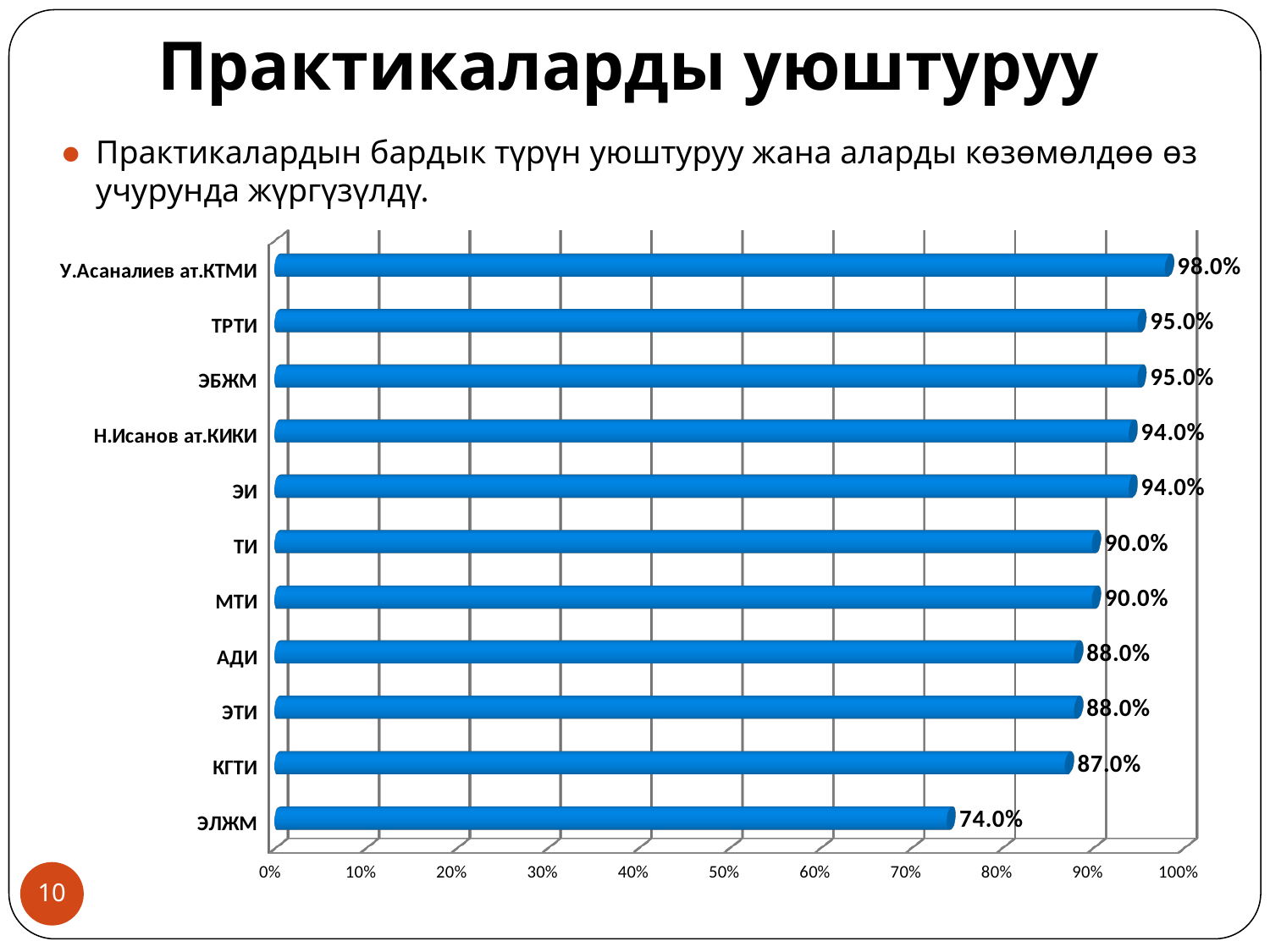
What is the value for ЭЛЖМ? 74.0% What kind of chart is shown on the slide? bar chart What is the value for У.Асаналиев ат.КТМИ? 98.0% What is the difference between the values for ТРТИ and КГТИ? 8.0% Which category has the lowest value? ЭЛЖМ What is the value for КГТИ? 87.0% How many categories are shown in the chart? 11 What is the difference between the values for У.Асаналиев ат.КТМИ and ЭЛЖМ? 24.0% What is the value for Н.Исанов ат.КИКИ? 94.0% Is the value for ЭЛЖМ greater or less than 80%? less Which is larger, the value for ТИ or the value for АДИ? ТИ Which category has the highest value? У.Асаналиев ат.КТМИ